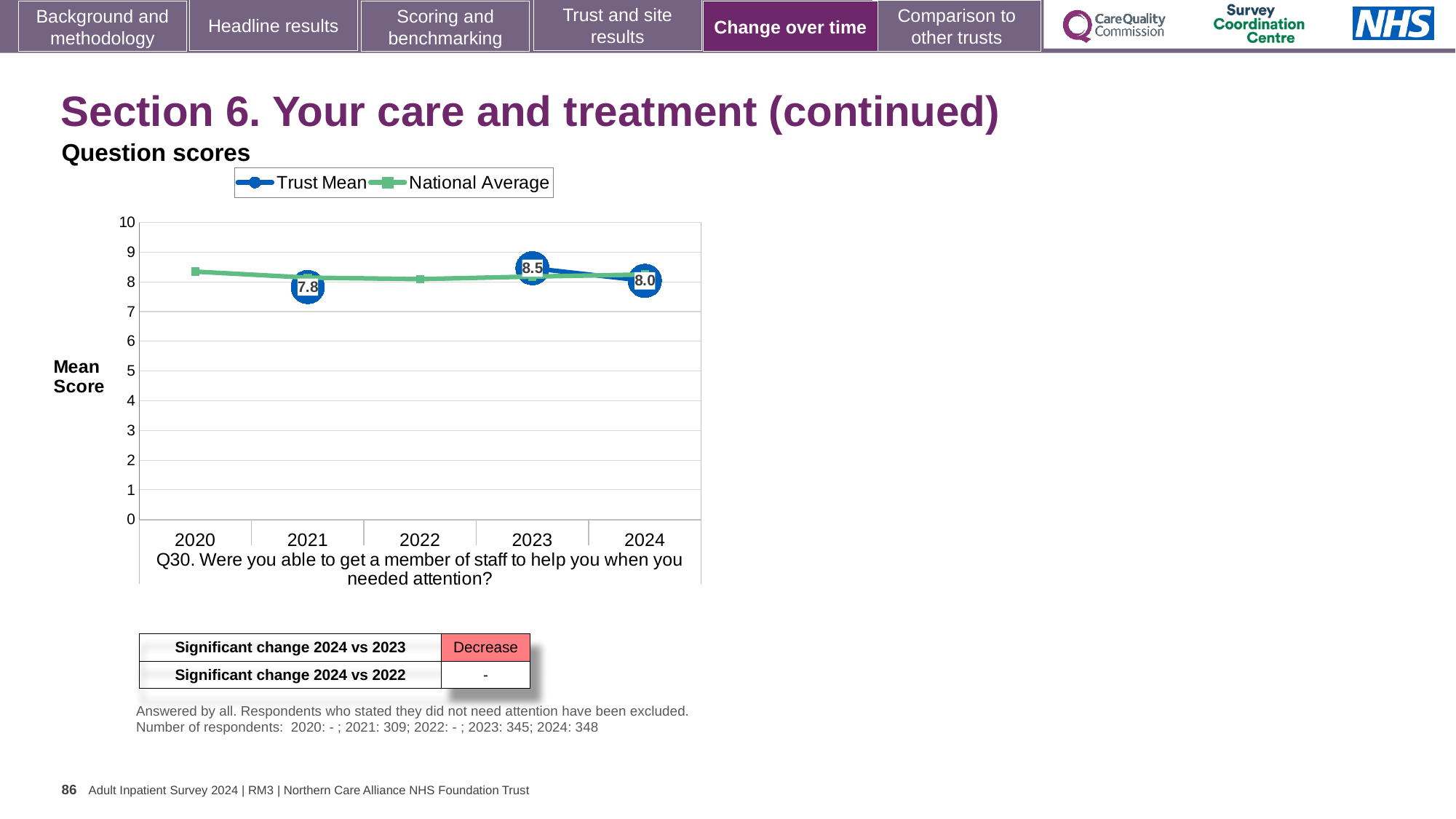
In which year is the labelled Trust Mean score highest? 2023 What is the difference between the Trust Mean scores for 2023 and 2021? 0.7 Is the National Average value for 2020 greater or less than 5? greater How many years are shown on the x axis? 5 What is the Trust Mean score for 2024? 8.0 What is the Trust Mean score for 2021? 7.8 In which year is the labelled Trust Mean score lowest? 2021 How many series does the legend list? 2 What kind of chart is shown on the slide? line chart Which year has the larger Trust Mean score, 2021 or 2024? 2024 What is the Trust Mean score for 2023? 8.5 By how much did the Trust Mean score fall from 2023 to 2024? 0.5